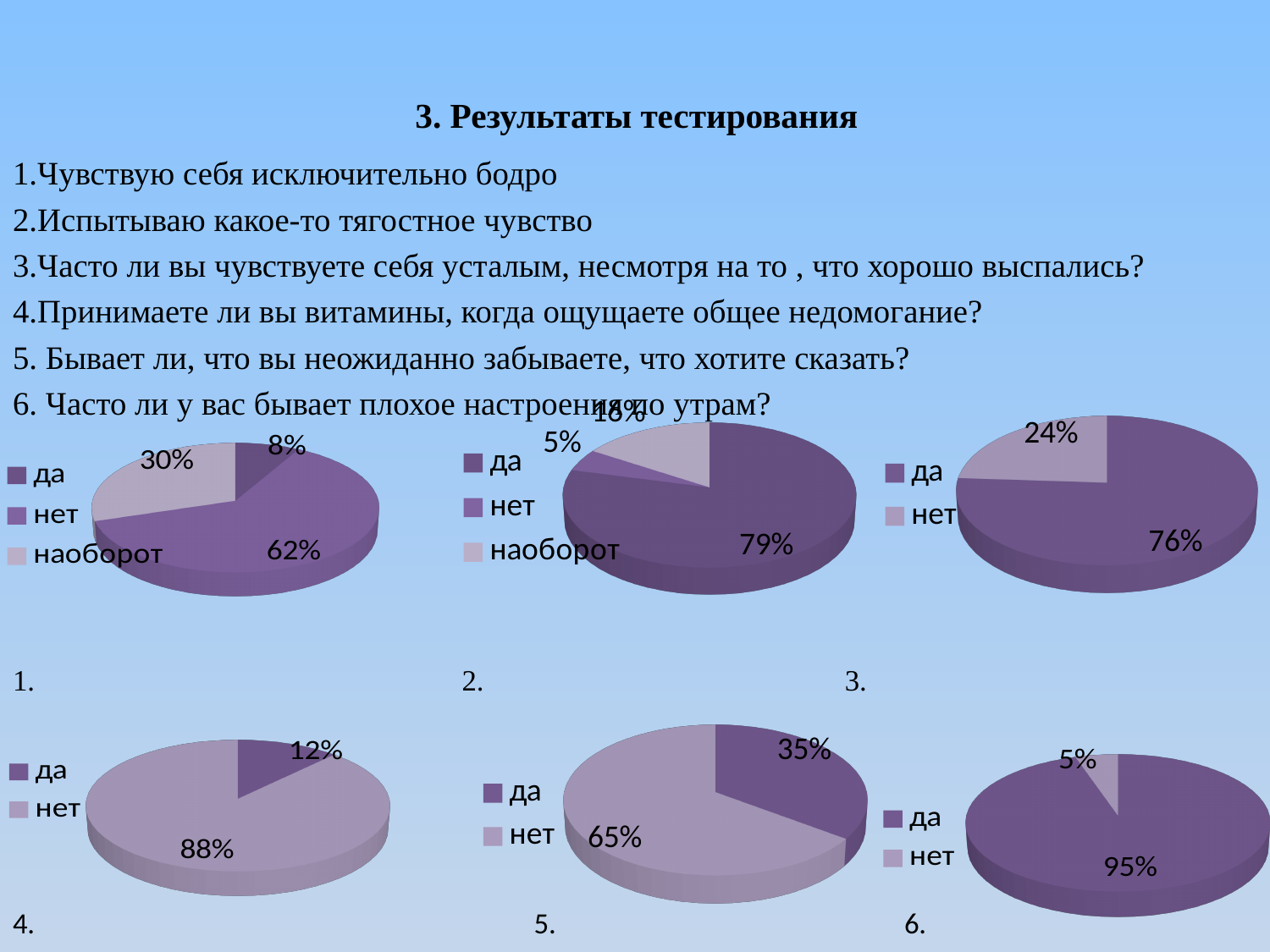
In pie chart 2, what share is labelled for "да"? 79% In pie chart 3, what is the difference between the "да" and "нет" shares? 52% In pie chart 3, what share is labelled for "нет"? 24% How many entries does the legend of pie chart 1 list? 3 In pie chart 2, which category has the largest slice? да In pie chart 4, what share is labelled for "да"? 12% In pie chart 1, which category has the smallest slice? да In pie chart 1, what share is labelled for "нет"? 62% In pie chart 1, what share is labelled for "наоборот"? 30% How many pie charts are shown on the slide? 6 In pie chart 6, what share is labelled for "да"? 95% In pie chart 5, which is larger, "да" or "нет"? нет